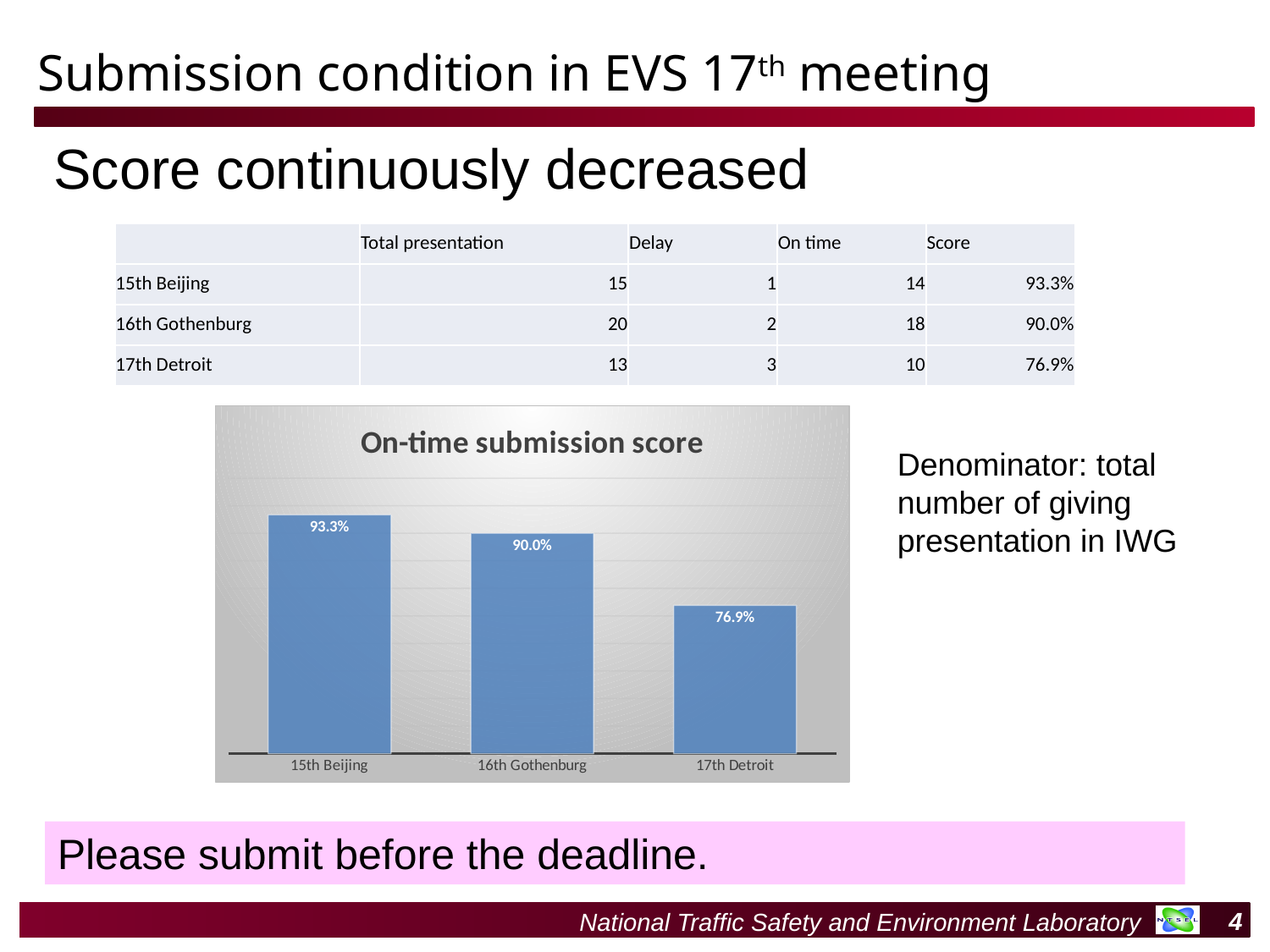
What is the difference in on-time submission score between 15th Beijing and 17th Detroit? 16.4% What is the on-time submission score for 17th Detroit? 76.9% Which meeting has the highest on-time submission score? 15th Beijing How many meetings are shown in the On-time submission score chart? 3 What kind of chart is the On-time submission score chart? Bar chart Which meeting has the lowest on-time submission score? 17th Detroit What is the on-time submission score for 16th Gothenburg? 90.0% Which has a higher on-time submission score, 16th Gothenburg or 17th Detroit? 16th Gothenburg What is the title of the chart on the slide? On-time submission score What is the on-time submission score for 15th Beijing? 93.3% Do the on-time submission scores rise or fall from 15th Beijing to 17th Detroit? Fall What is the difference in on-time submission score between 16th Gothenburg and 17th Detroit? 13.1%